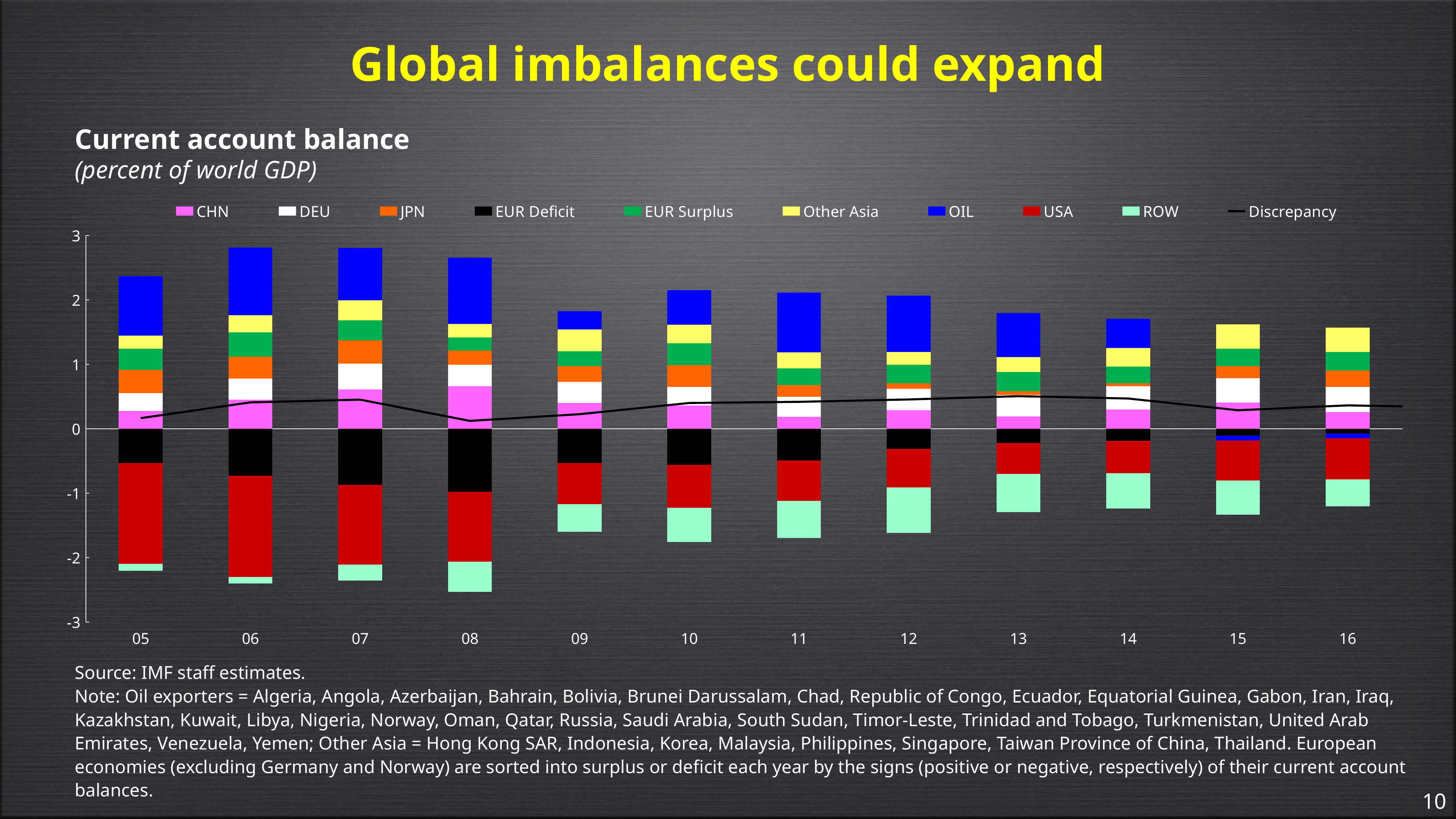
What is the title of the chart? Current account balance Is the top of the positive stacked bar for 16 greater or less than 2? less Is the bottom of the negative stacked bar for 08 greater or less than -2? less How many years (categories) are shown on the x axis of the chart? 12 What kind of chart is shown on the slide? Stacked bar chart with a line How many series does the chart's legend list? 10 Which year has the taller positive stacked bar, 06 or 16? 06 Which series in the chart is drawn as a line rather than as bars? Discrepancy Is the Discrepancy line value for 13 greater or less than 1? less Which year has the larger USA (red) segment, 05 or 16? 05 Does the height of the positive stacked bar rise or fall from 08 to 16? fall